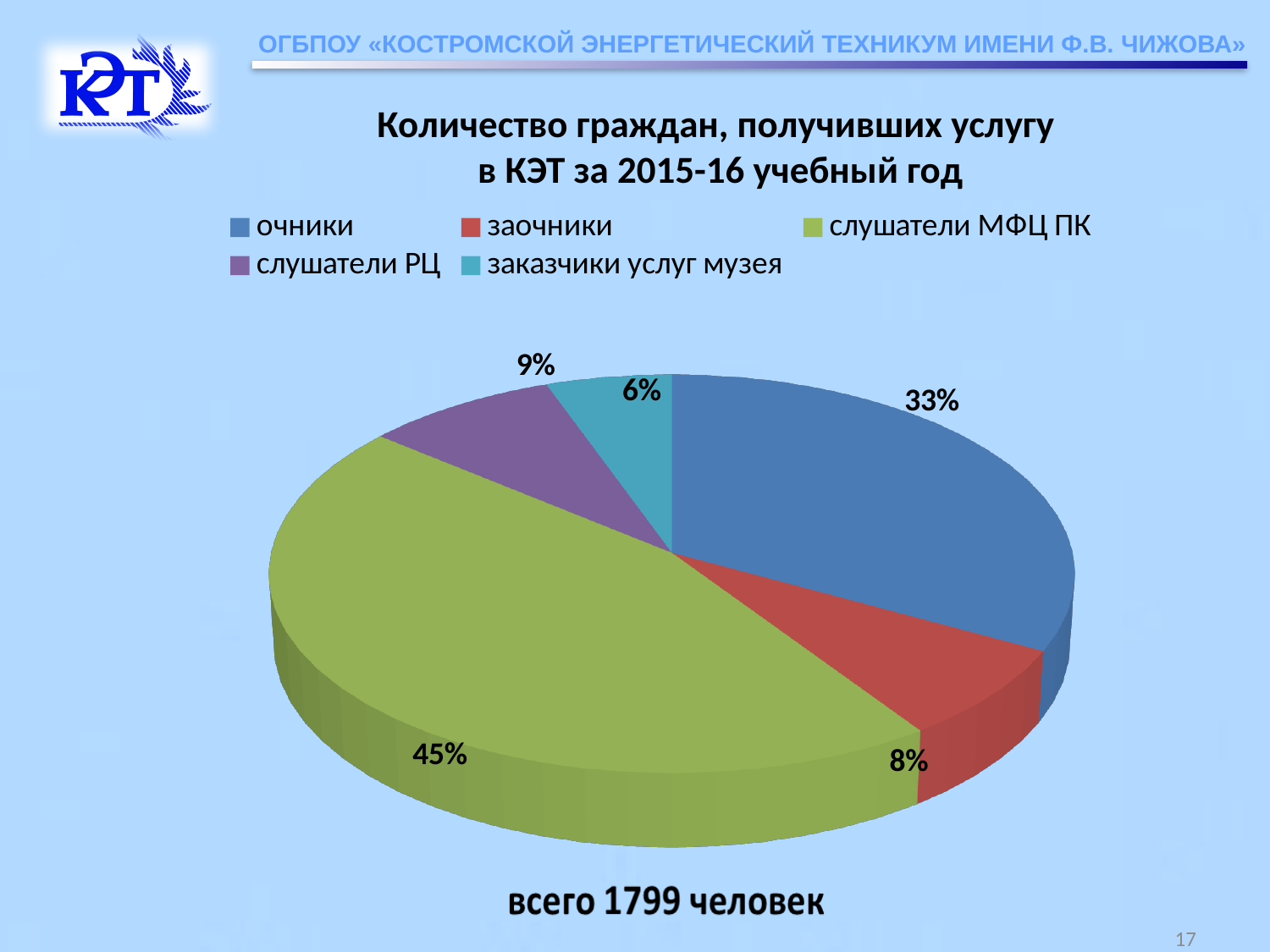
Which slice is larger, слушатели РЦ or заочники? слушатели РЦ Which category has the smallest slice of the pie? заказчики услуг музея What share of the pie does the slice for очники represent? 33% What share of the pie does the slice for заочники represent? 8% What kind of chart is shown on the slide? pie chart How many categories does the legend list? 5 What total number of people is stated below the chart? 1799 человек What share of the pie does the slice for заказчики услуг музея represent? 6% What is the difference in percentage points between the slices for слушатели МФЦ ПК and очники? 12% Which category has the largest slice of the pie? слушатели МФЦ ПК